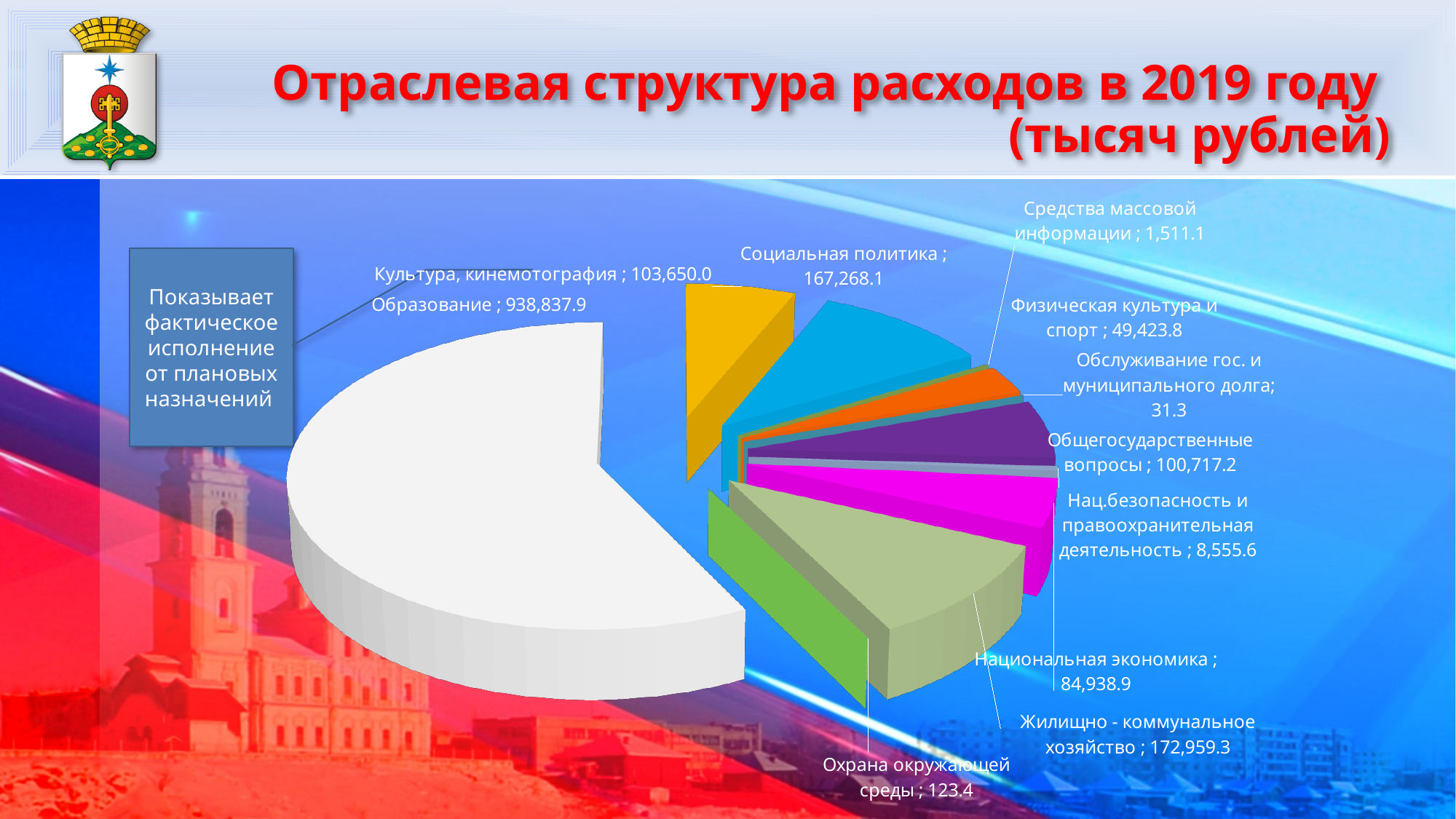
Which category has the largest value? Образование What is the value for Национальная экономика? 84,938.9 Which category has the smallest value? Обслуживание гос. и муниципального долга What kind of chart is shown on the slide? Pie chart What is the difference between Культура, кинемотография and Общегосударственные вопросы? 2,932.8 What is the difference between Жилищно - коммунальное хозяйство and Социальная политика? 5,691.2 What is the value for Жилищно - коммунальное хозяйство? 172,959.3 Which is larger, Национальная экономика or Физическая культура и спорт? Национальная экономика What is the value for Обслуживание гос. и муниципального долга? 31.3 How many categories are shown in the chart? 11 What is the title of the slide? Отраслевая структура расходов в 2019 году (тысяч рублей) What is the value for Образование? 938,837.9